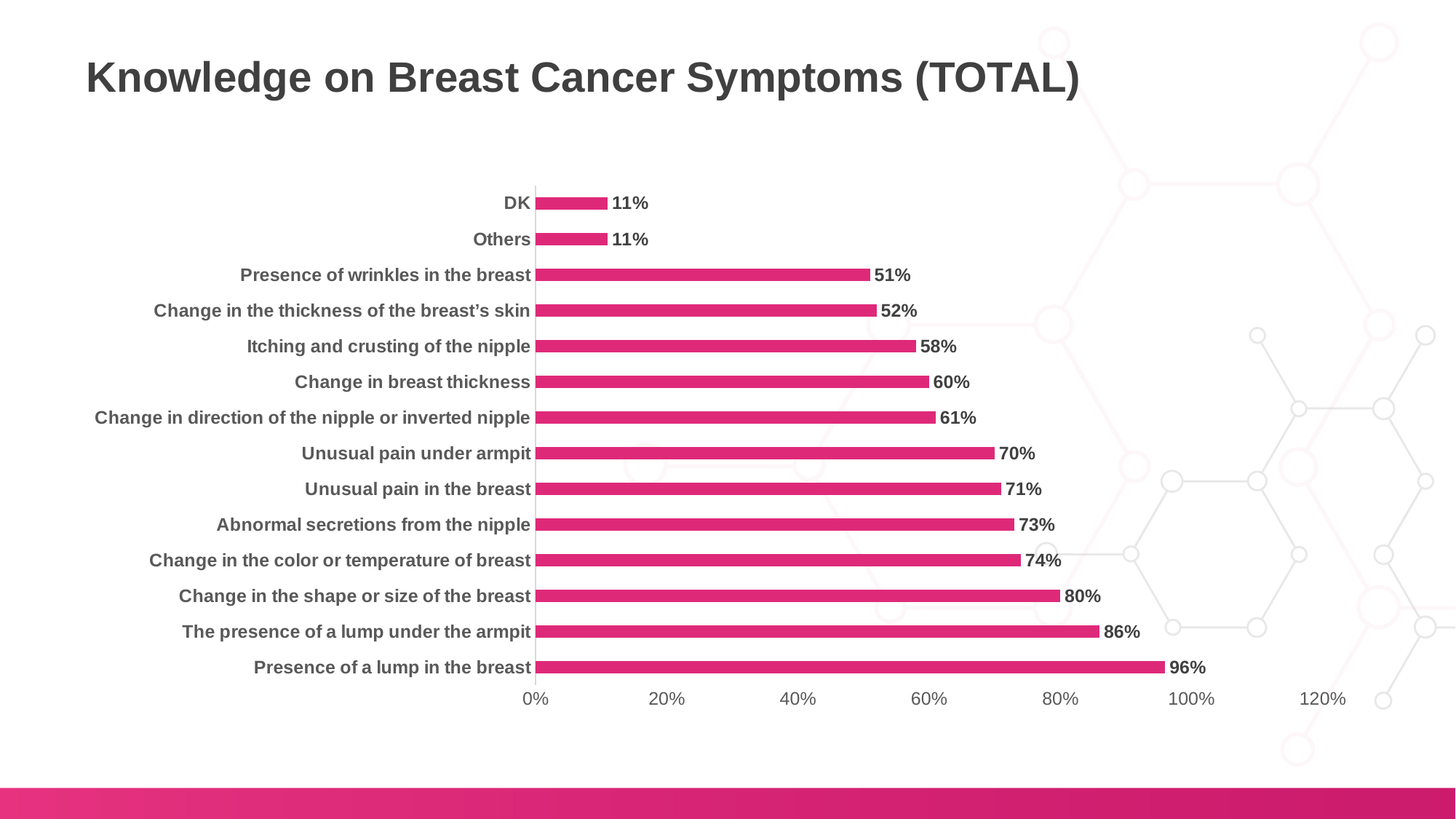
How many categories are shown in the chart? 14 What is the difference between "The presence of a lump under the armpit" and "Change in the shape or size of the breast"? 6% What is the value for "Presence of a lump in the breast"? 96% What is the value for "Presence of wrinkles in the breast"? 51% What is the value for "Unusual pain under armpit"? 70% What is the title of the chart? Knowledge on Breast Cancer Symptoms (TOTAL) What is the difference between "Presence of a lump in the breast" and "DK"? 85% Is the value for "Change in the color or temperature of breast" greater or less than 60%? greater Which is larger: "Abnormal secretions from the nipple" or "Change in breast thickness"? Abnormal secretions from the nipple What is the value for "Itching and crusting of the nipple"? 58% Which category has the highest value? Presence of a lump in the breast What kind of chart is shown on the slide? Bar chart